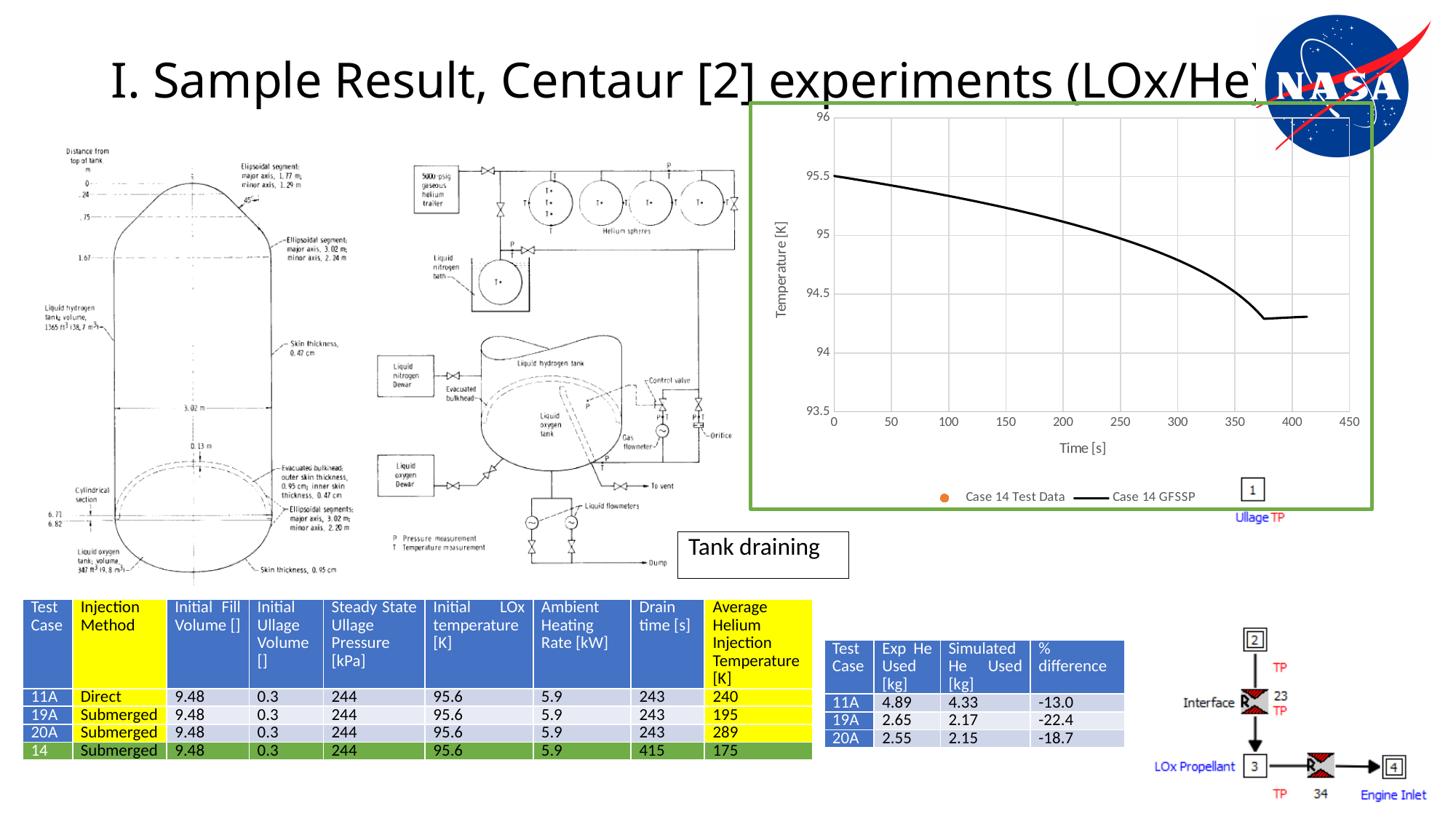
Is the Case 14 GFSSP temperature at 400 s greater or less than 94.5? less What kind of chart is shown on the slide? line chart What are the two series named in the chart's legend? Case 14 Test Data and Case 14 GFSSP Is the Case 14 GFSSP temperature at 300 s greater or less than 94.5? greater Is the Case 14 GFSSP temperature at 100 s greater or less than 95? greater How many series does the chart's legend list? 2 What is the Case 14 GFSSP temperature at time 0 s? 95.5 Does the Case 14 GFSSP temperature rise or fall as time increases? fall What is the label of the chart's x axis? Time [s]